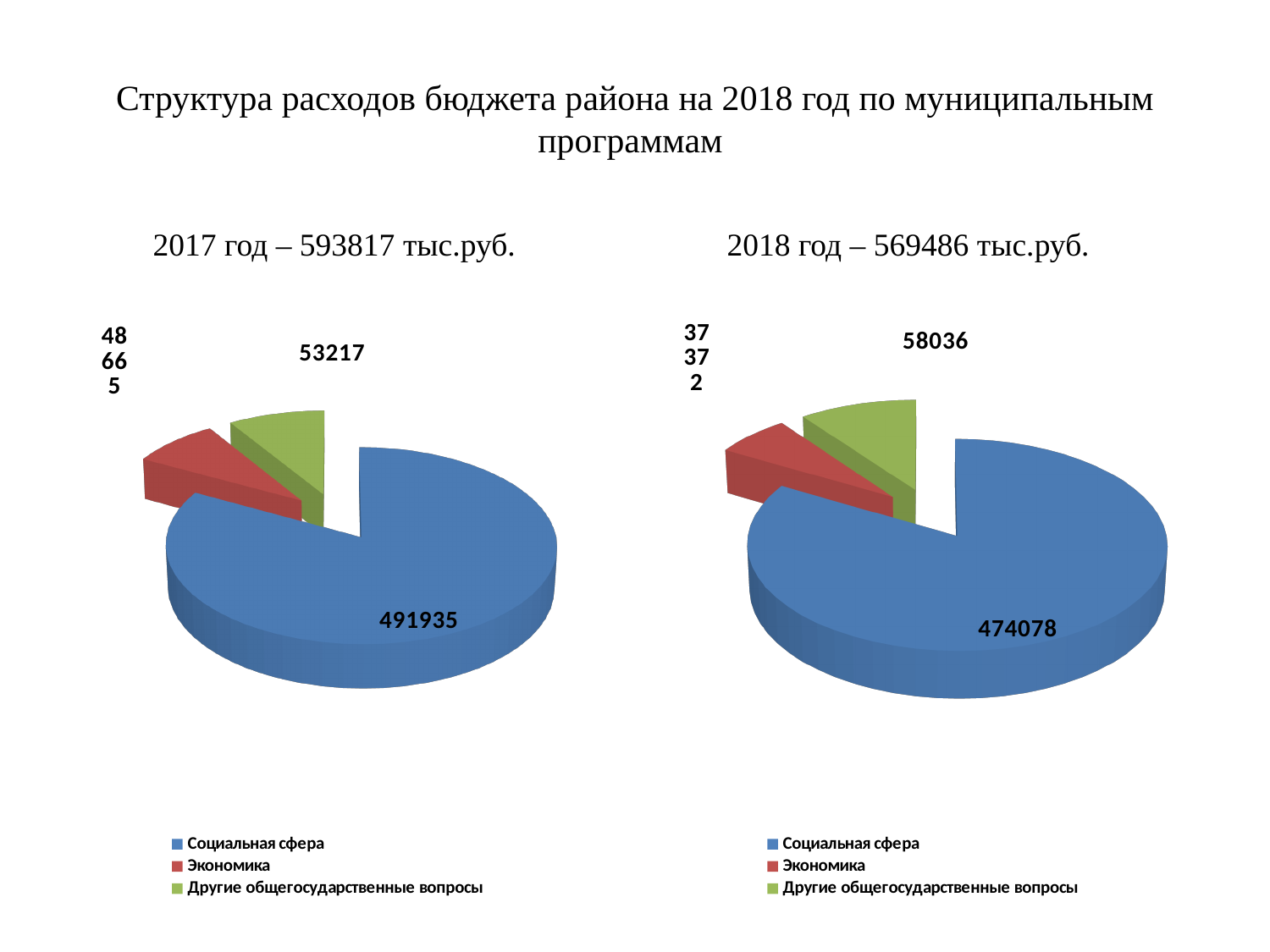
In the 2018 год chart, what is the value for Экономика? 37372 What is the difference between the Социальная сфера value in the 2017 год chart and in the 2018 год chart? 17857 What type of chart is used on the left (2017 год) side of the slide? pie chart How many entries does the legend of the 2018 год chart list? 3 Which is larger: Другие общегосударственные вопросы in the 2018 год chart or in the 2017 год chart? 2018 год In the 2018 год chart, what is the value for Социальная сфера? 474078 In the 2017 год chart, what is the value for Другие общегосударственные вопросы? 53217 In the 2017 год chart, what is the value for Социальная сфера? 491935 What colour represents Экономика in the legends of both charts? red In the 2018 год chart, which category has the largest slice? Социальная сфера How many slices does the 2017 год pie chart have? 3 In the 2018 год chart, which category has the smallest slice? Экономика